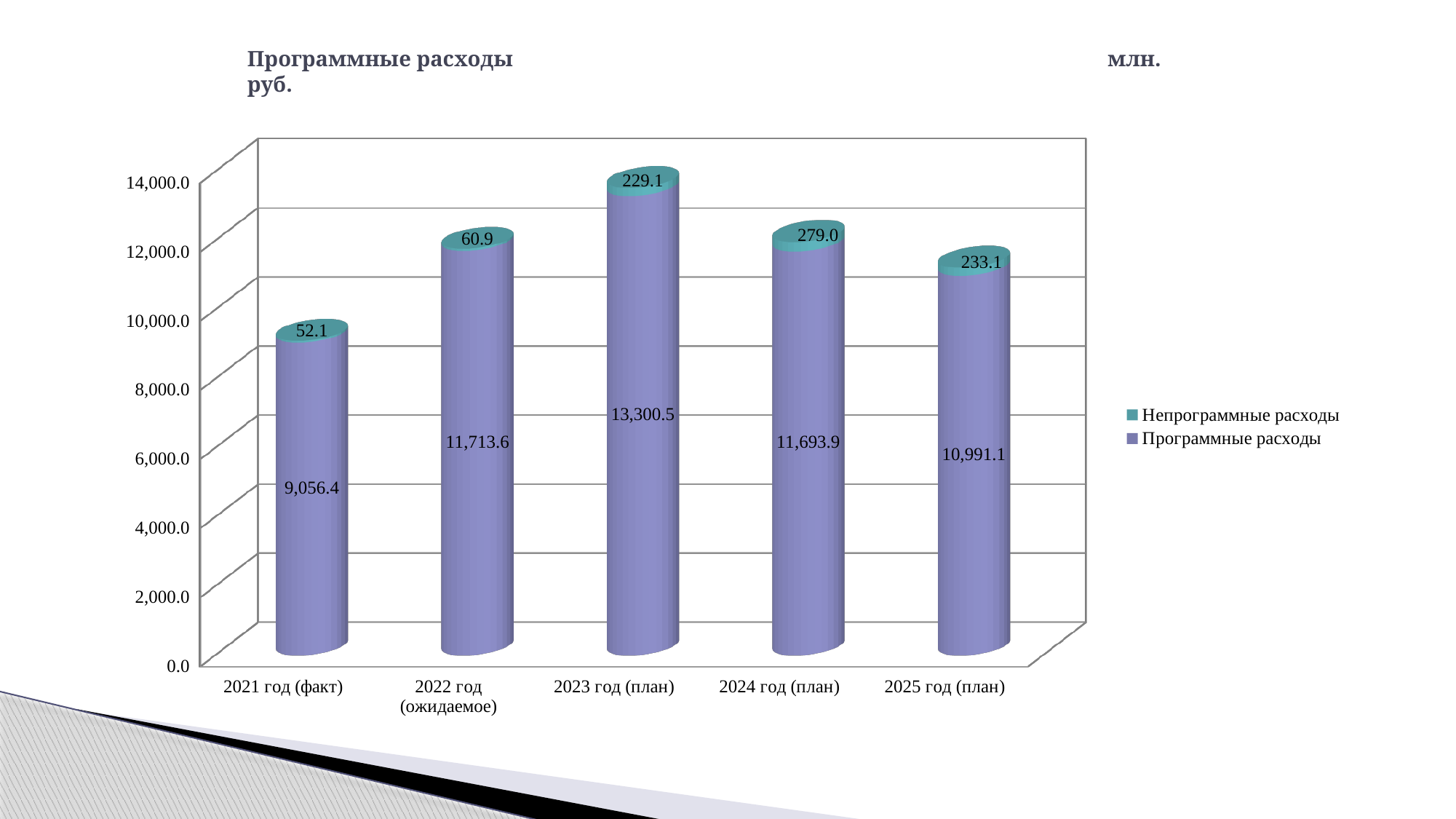
How many series does the legend list? 2 Which is larger: Программные расходы for 2024 год (план) or for 2025 год (план)? 2024 год (план) Which category has the lowest value of Непрограммные расходы? 2021 год (факт) What is the difference between Программные расходы for 2023 год (план) and 2022 год (ожидаемое)? 1,586.9 What is the value of Программные расходы for 2023 год (план)? 13,300.5 What is the value of Непрограммные расходы for 2024 год (план)? 279.0 What is the total of the stacked bar for 2021 год (факт)? 9,108.5 Which category has the highest value of Программные расходы? 2023 год (план) What is the value of Программные расходы for 2021 год (факт)? 9,056.4 How many categories are shown on the x axis? 5 Which series is shown in teal in the legend? Непрограммные расходы What kind of chart is shown on the slide? Stacked bar chart